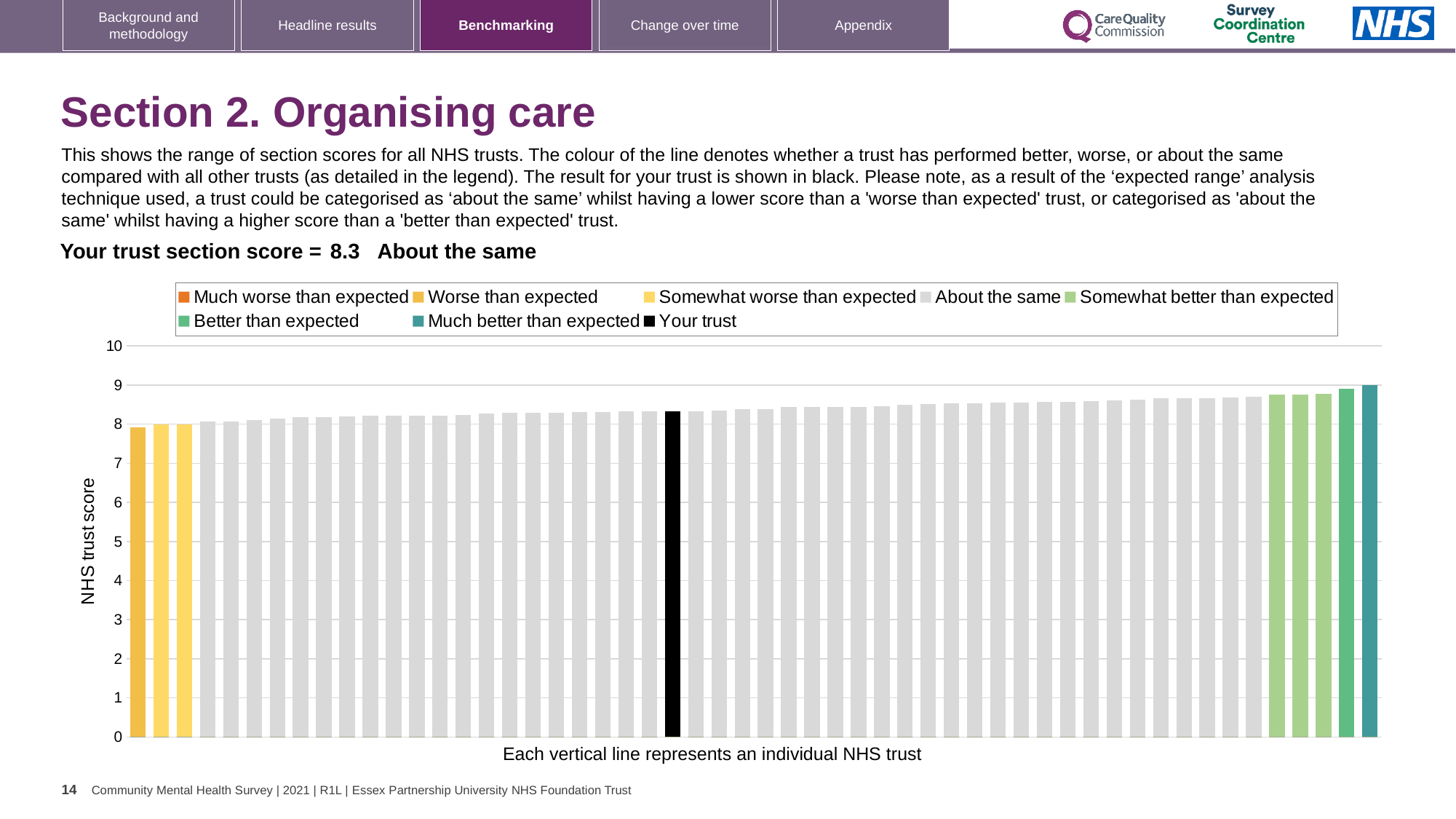
How many entries does the chart legend list? 8 What colour is used for the bar representing your trust? black Is the value of the highest bar on the chart greater or less than 8? greater Is the value of the highest bar on the chart greater or less than 10? less What kind of chart is shown on the slide? bar chart What is the section score for your trust shown on the slide? 8.3 Which legend category does the highest bar on the chart belong to? Much better than expected Is the value for your trust (the black bar) greater or less than 8? greater Which performance category is your trust placed in for this section? About the same What is the label on the vertical axis of the chart? NHS trust score Do the bar values rise or fall from left to right along the x axis? rise